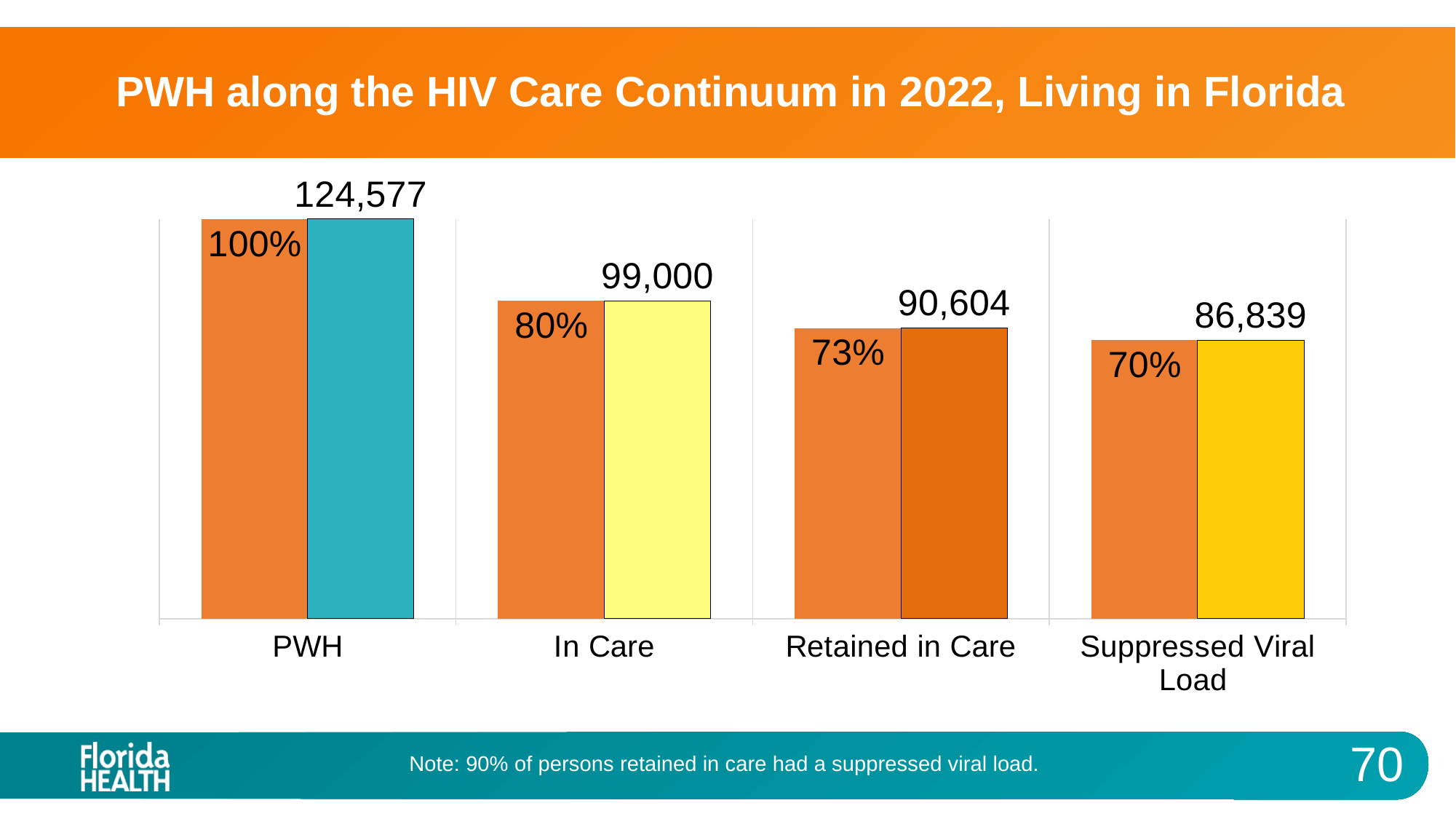
What percentage is shown for the In Care category? 80% What is the number shown for Suppressed Viral Load? 86,839 Which category has the highest number of people? PWH Which category has the lowest percentage? Suppressed Viral Load What percentage is shown for Suppressed Viral Load? 70% What is the number shown for Retained in Care? 90,604 What is the difference between the number In Care and the number Retained in Care? 8,396 Which is larger, the number Retained in Care or the number with Suppressed Viral Load? Retained in Care How many categories are shown on the x axis? 4 Do the values rise or fall moving from left to right along the x axis? fall What is the difference in percentage points between In Care and Suppressed Viral Load? 10 What is the number of PWH shown on the chart? 124,577